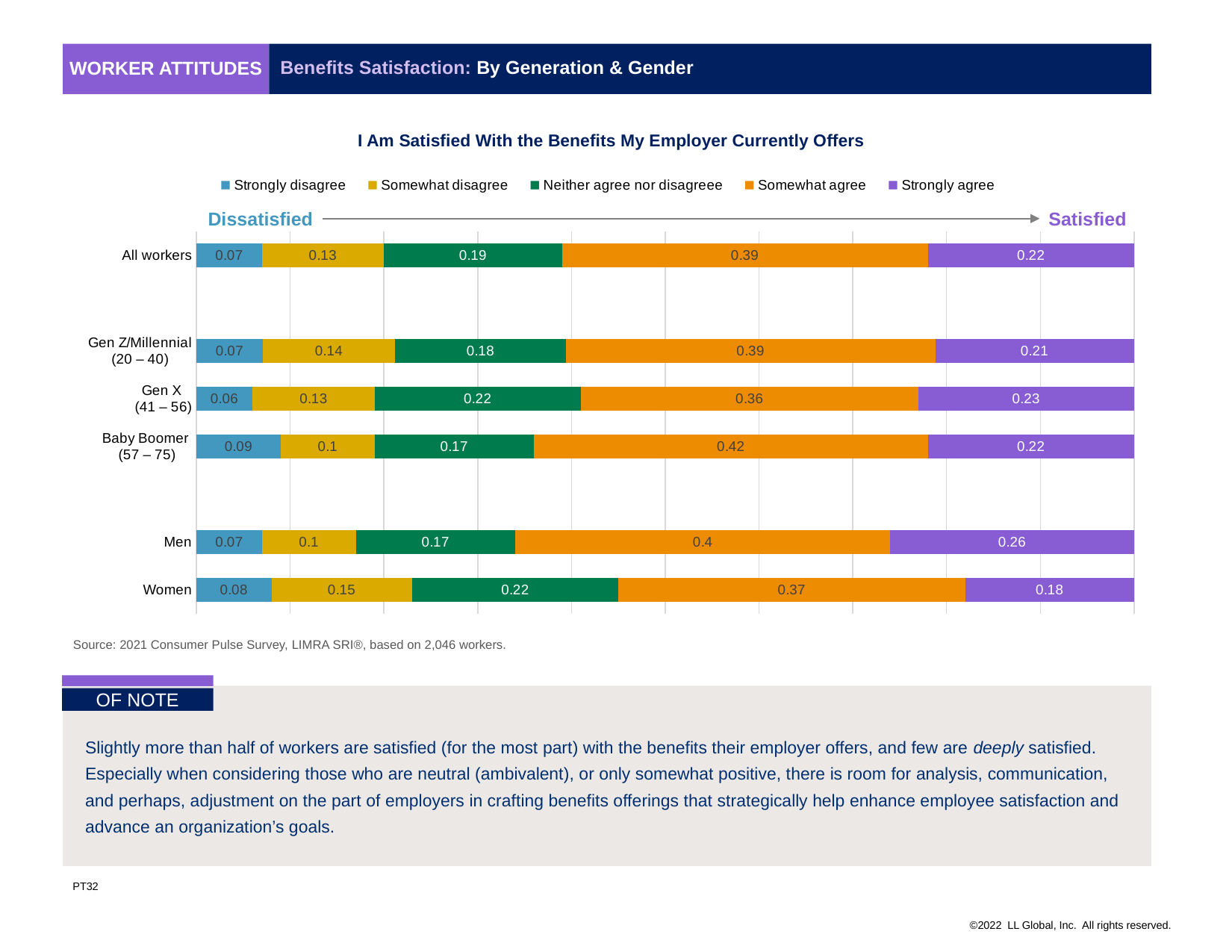
What is the title of the chart? I Am Satisfied With the Benefits My Employer Currently Offers What is the value for Neither agree nor disagreee for Women? 0.22 How many categories are shown on the y axis? 6 What kind of chart is shown? Stacked bar chart What is the value for Somewhat agree for All workers? 0.39 What is the difference between the Strongly agree values for Men and Women? 0.08 How many series does the legend list? 5 What is the value for Strongly disagree for Baby Boomer (57 – 75)? 0.09 What is the value for Strongly agree for Men? 0.26 Which category has the highest value for Somewhat agree? Baby Boomer (57 – 75) Which is larger, the Somewhat disagree value for Women or for Men? Women Which category has the lowest value for Strongly agree? Women